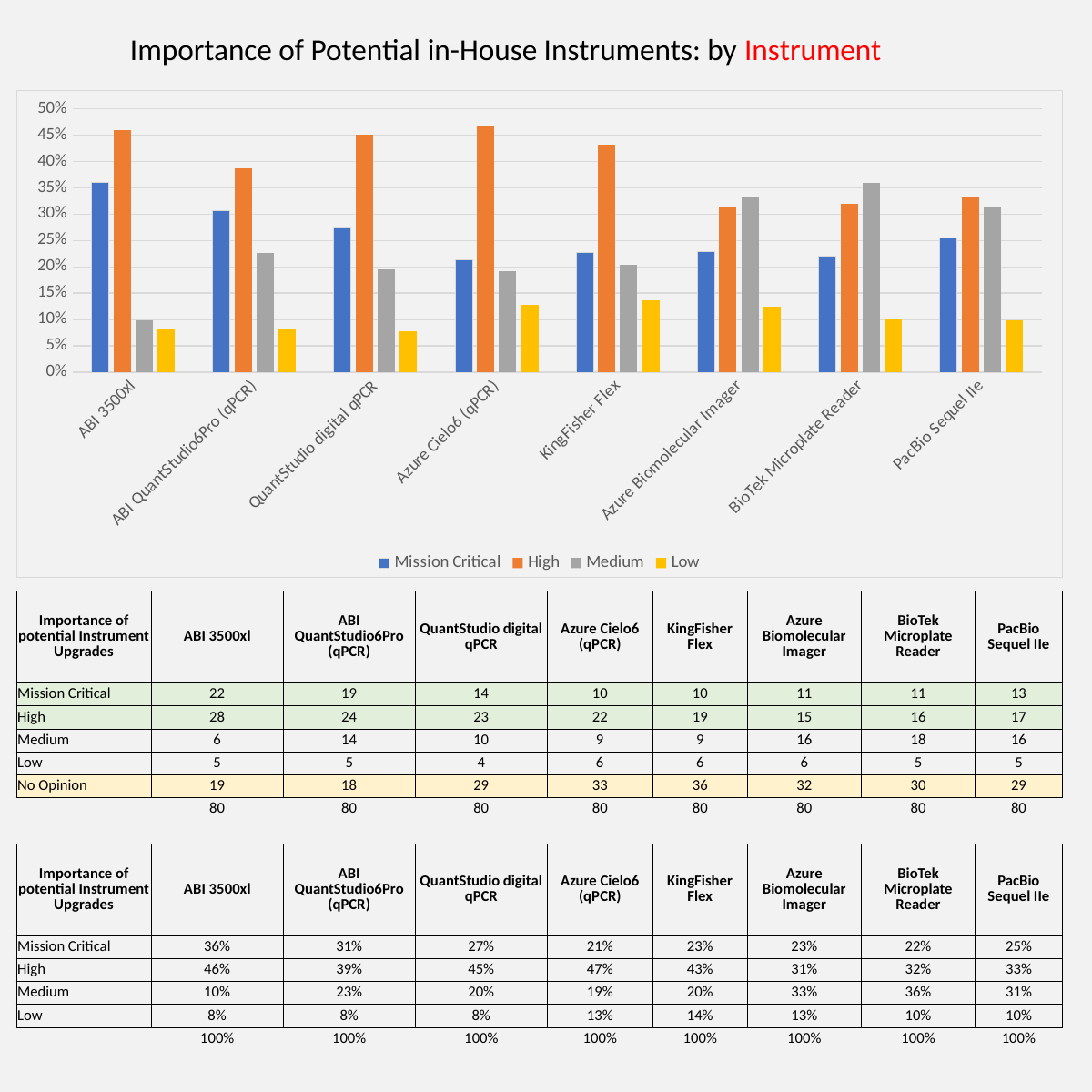
Which colour represents the Low series in the chart's legend? yellow According to the percentage table, what is the Mission Critical value for ABI 3500xl? 36% Which instrument has the lowest Medium bar in the chart? ABI 3500xl For BioTek Microplate Reader, which is larger: the Medium bar or the High bar? Medium Is the High value for ABI 3500xl greater or less than 40%? greater According to the percentage table, what is the High value for Azure Cielo6 (qPCR)? 47% How many instruments are shown along the x axis of the chart? 8 What kind of chart is shown on the slide? bar chart How many series does the chart's legend list? 4 Which instrument has the highest Mission Critical bar in the chart? ABI 3500xl Is the Low value for QuantStudio digital qPCR greater or less than 10%? less Using the percentage table, what is the difference between the High and Mission Critical values for ABI 3500xl? 10 percentage points